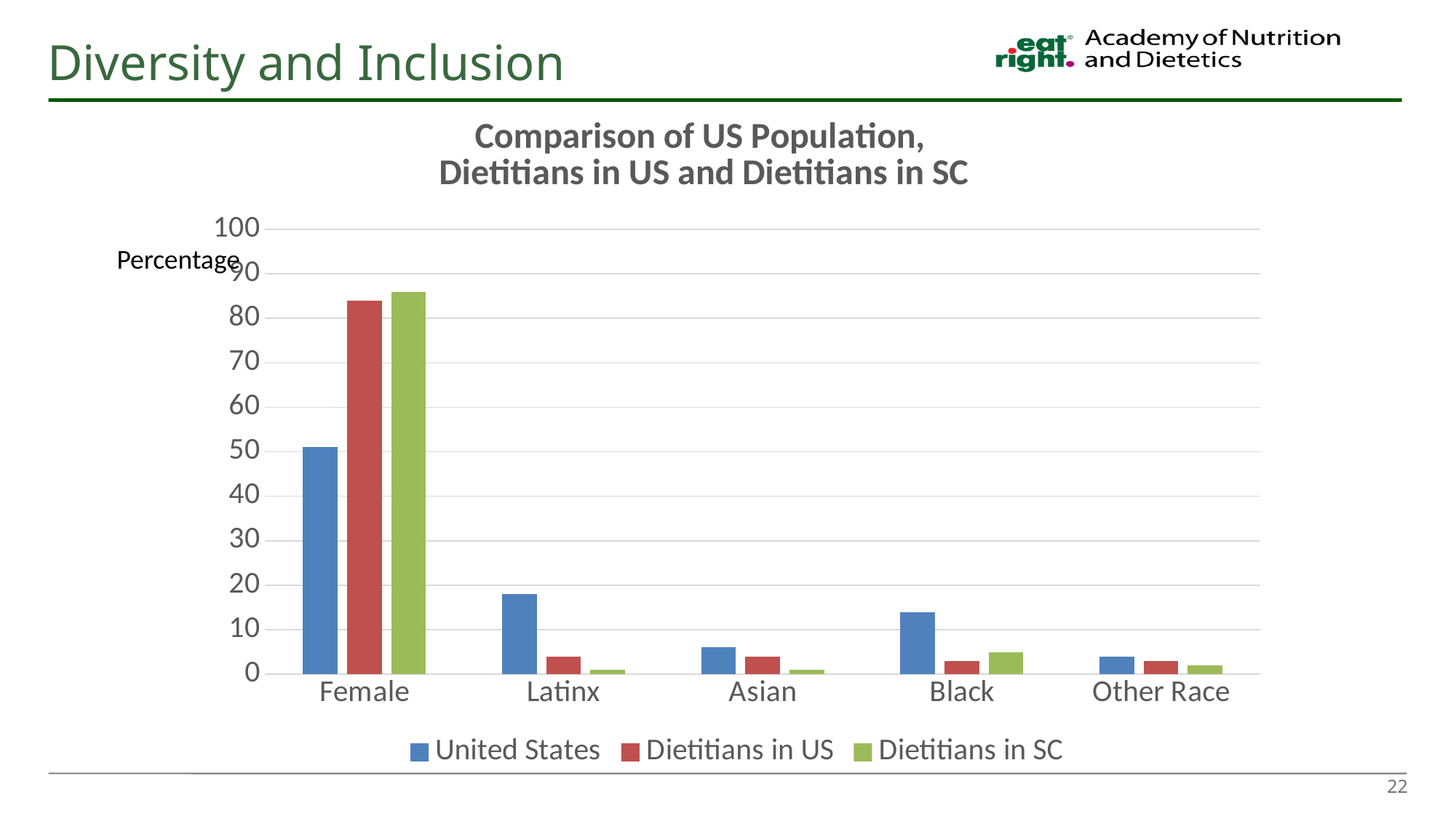
How many series does the legend list? 3 What kind of chart is shown on the slide? bar chart For the Latinx category, which is larger: the United States value or the Dietitians in SC value? United States Is the value for Black in the Dietitians in SC series greater or less than 10? less Is the value for Latinx in the United States series greater or less than 10? greater Is the value for Female in the United States series greater or less than 40? greater Which category has the highest value for the United States series? Female Which category has the highest value for the Dietitians in SC series? Female How many categories are shown on the x axis? 5 What is the title of the chart? Comparison of US Population, Dietitians in US and Dietitians in SC For the Female category, which is larger: the United States value or the Dietitians in US value? Dietitians in US